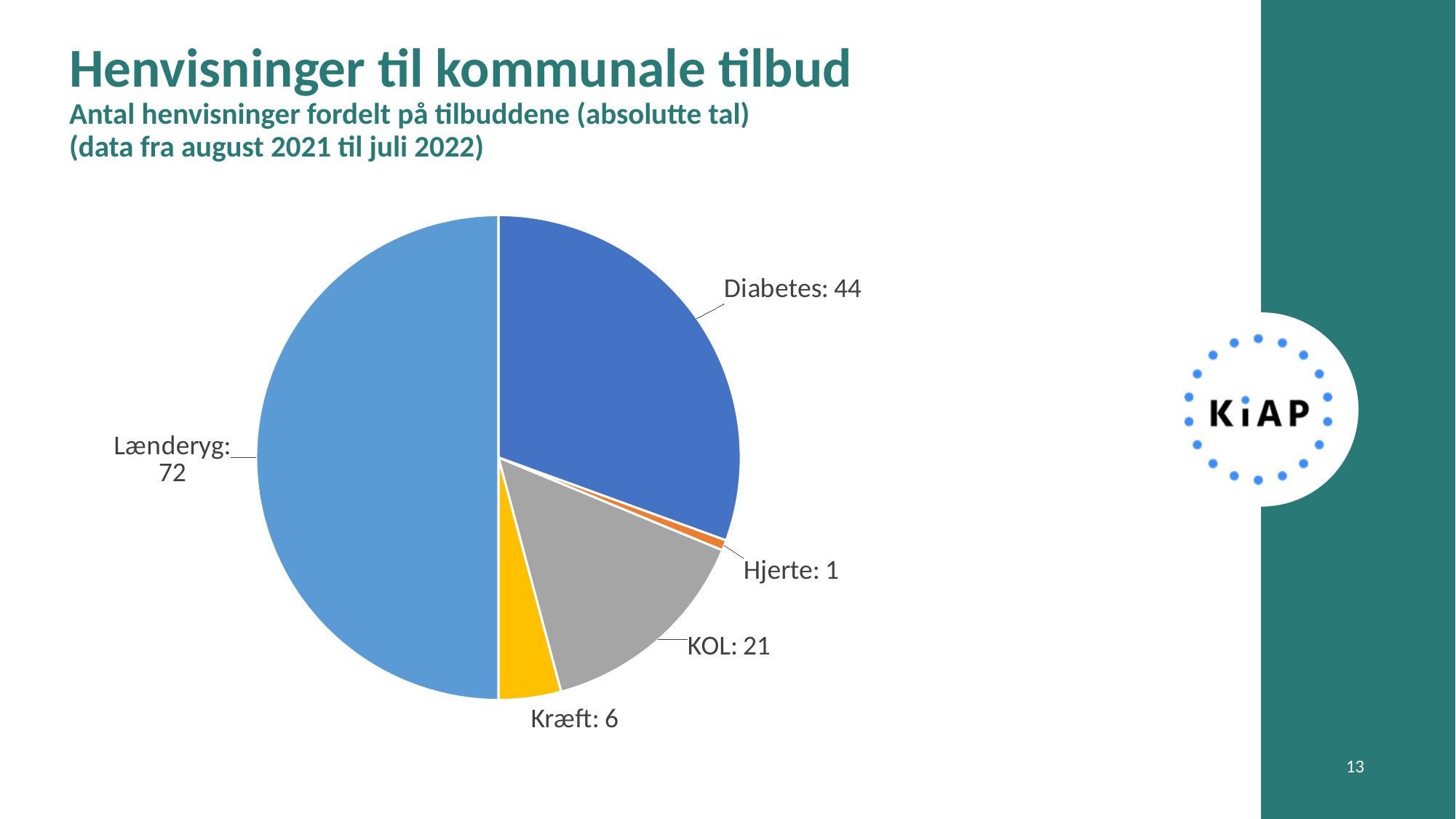
Which category has the largest slice of the pie chart? Lænderyg How many categories does the pie chart show? 5 What is the total of all values shown in the pie chart? 144 What is the value shown for KOL in the pie chart? 21 What share of the pie does Lænderyg represent? 50% What is the difference between the values for KOL and Kræft? 15 What kind of chart is shown on the slide? Pie chart What is the value shown for Kræft? 6 What is the difference between the values for Lænderyg and Diabetes? 28 Which category has the smallest slice of the pie chart? Hjerte How many referrals does the pie chart show for Diabetes? 44 Which is larger, the value for Diabetes or the value for KOL? Diabetes